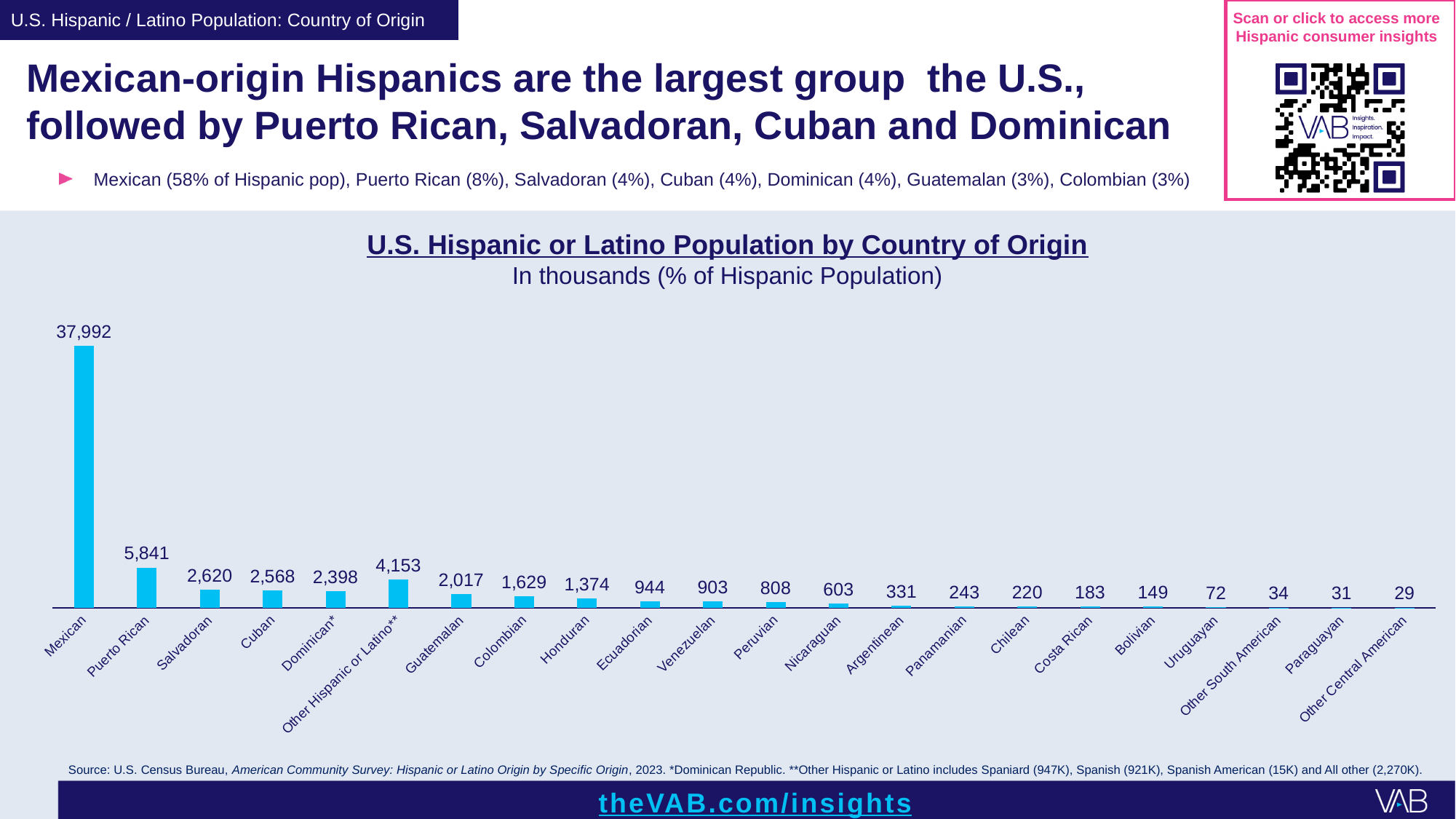
Which is larger, the value for Cuban or the value for Guatemalan? Cuban What kind of chart is this? Bar chart What is the value for Puerto Rican? 5,841 What is the difference between the values for Guatemalan and Colombian? 388 How many categories are shown on the x axis? 22 What is the value for Mexican? 37,992 Which category has the highest value? Mexican What is the value for Honduran? 1,374 What is the title of the chart? U.S. Hispanic or Latino Population by Country of Origin Which category has the lowest value? Other Central American What is the value for Other Hispanic or Latino**? 4,153 What is the difference between the values for Mexican and Puerto Rican? 32,151